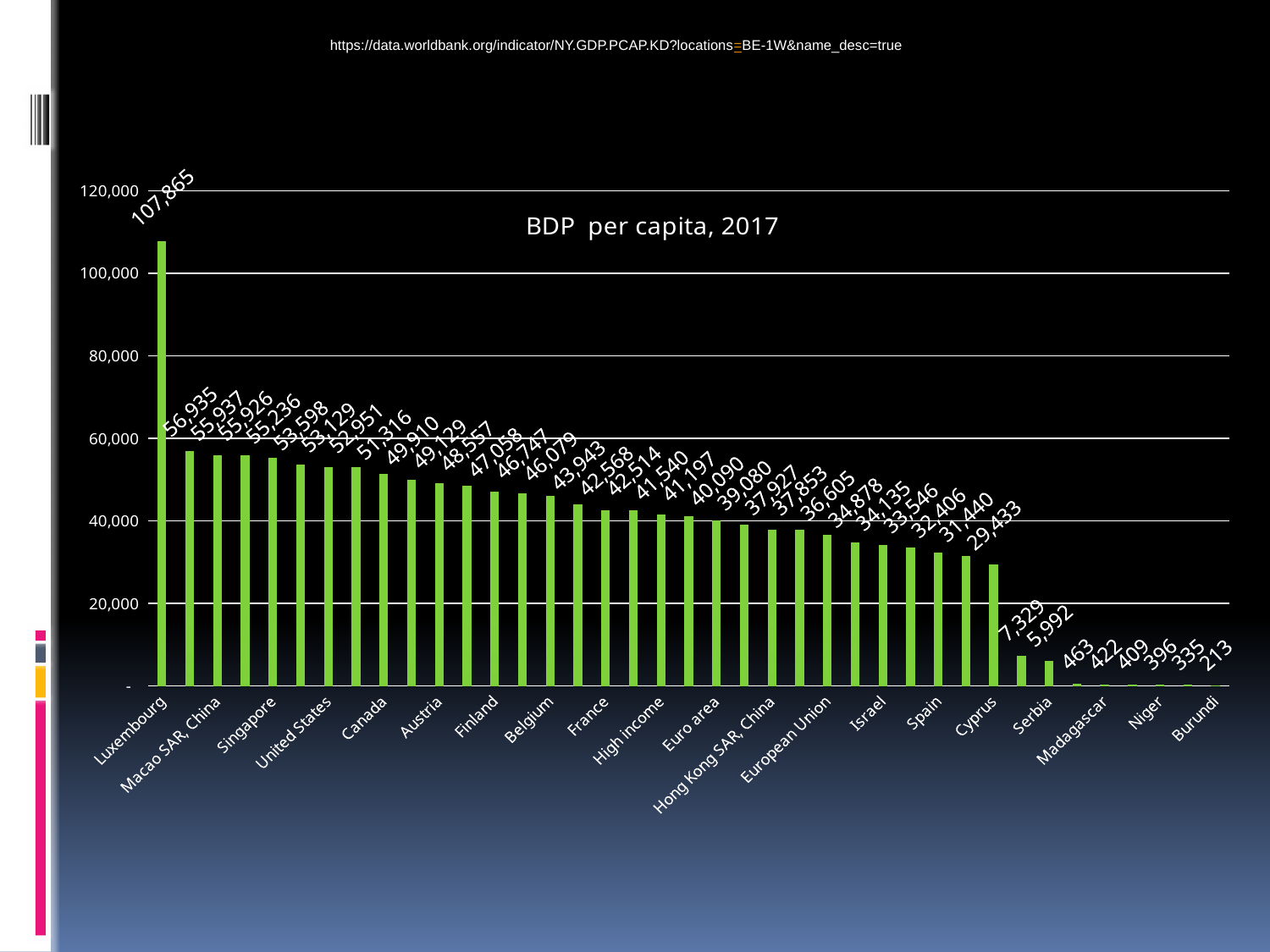
What is the difference between the values for Luxembourg and Burundi? 107,652 What is the title of the chart? BDP per capita, 2017 Do the values rise or fall from left to right along the x axis? fall What is the value for Cyprus? 29,433 Which category has the lowest value in the chart? Burundi What kind of chart is shown on the slide? bar chart What is the value for Serbia? 5,992 Which category has the highest value in the chart? Luxembourg Which is larger, the value for Luxembourg or the value for Cyprus? Luxembourg What is the value for Burundi? 213 What is the value for Luxembourg? 107,865 Is the value for Luxembourg greater or less than 100,000? greater